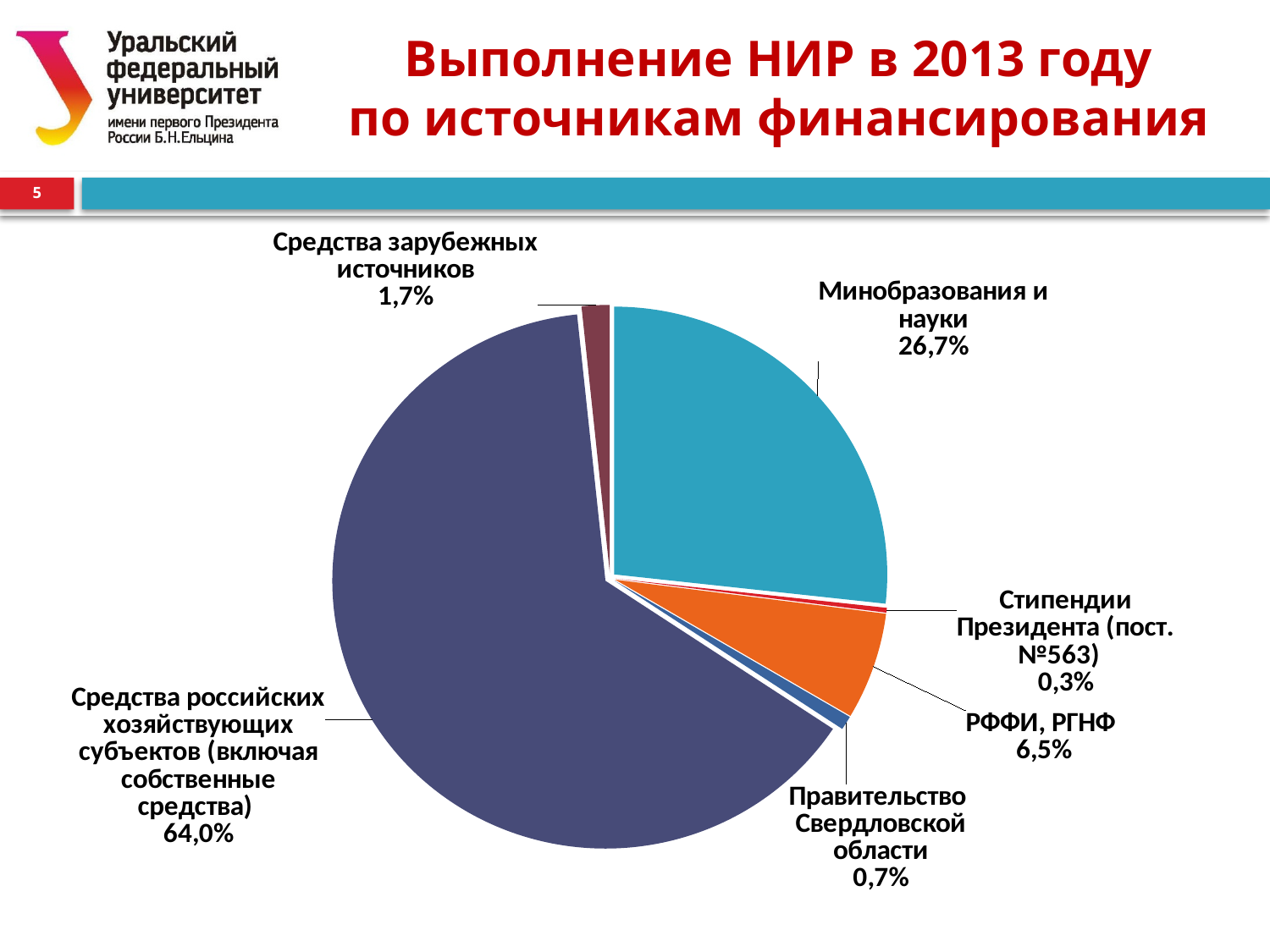
What kind of chart is shown on the slide? pie chart What share of the pie does "Минобразования и науки" have? 26,7% What share of the pie does "Стипендии Президента (пост. №563)" have? 0,3% What is the difference between the shares of "Минобразования и науки" and "РФФИ, РГНФ"? 20,2% What share of the pie does "РФФИ, РГНФ" have? 6,5% Which is larger: the share of "Средства зарубежных источников" or the share of "Правительство Свердловской области"? Средства зарубежных источников What is the title of the slide containing the chart? Выполнение НИР в 2013 году по источникам финансирования What share of the pie does "Средства зарубежных источников" have? 1,7% What share of the pie does "Правительство Свердловской области" have? 0,7% How many slices does the pie chart have? 6 Which funding source has the largest slice of the pie? Средства российских хозяйствующих субъектов (включая собственные средства) Which funding source has the smallest slice of the pie? Стипендии Президента (пост. №563)